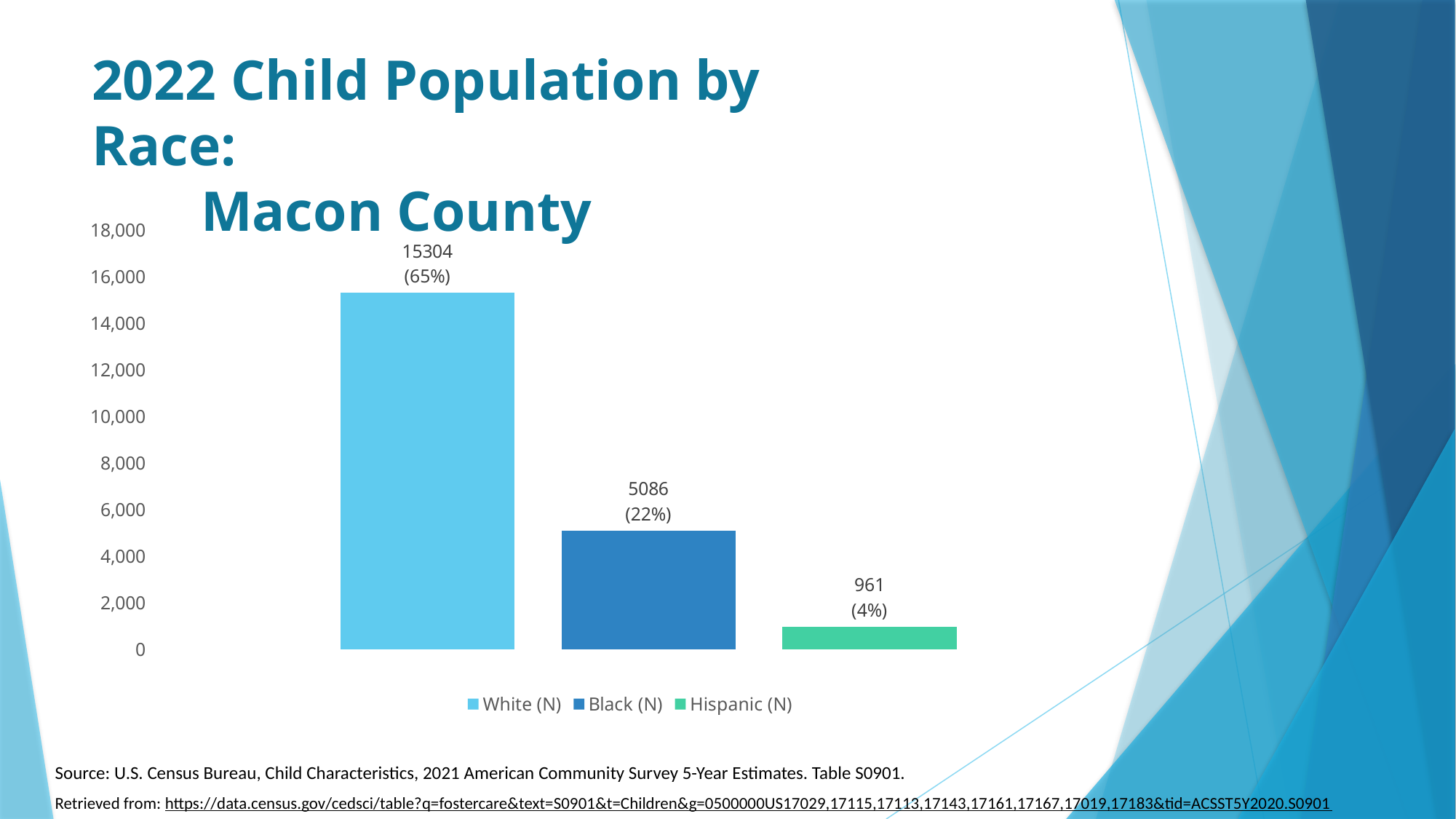
What is the difference between the White (N) and Black (N) values? 10218 Which category has the highest value? White (N) Which is larger, the value for Black (N) or Hispanic (N)? Black (N) Is the value for Black (N) greater or less than 6,000? less Which category has the lowest value? Hispanic (N) What percentage is shown for Black (N)? 22% What is the value for Hispanic (N)? 961 How many series does the legend list? 3 What is the value for White (N)? 15304 What colour is the bar for Hispanic (N)? green What is the value for Black (N)? 5086 What kind of chart is shown on the slide? bar chart